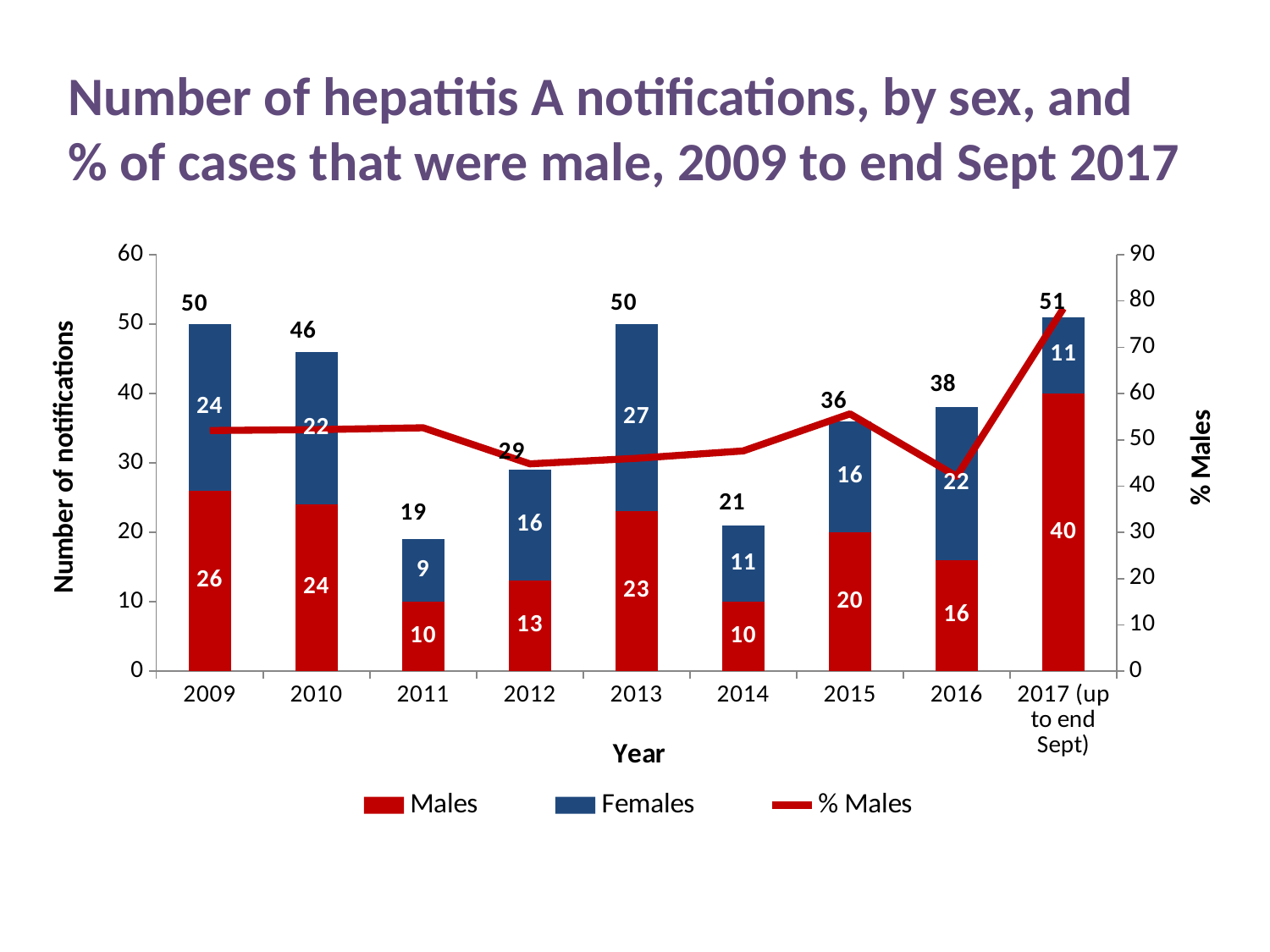
What is the total number of notifications shown for 2016? 38 What is the difference between the number of male notifications in 2009 and in 2011? 16 How many years are shown on the x axis? 9 In 2012, which is larger: the number of male notifications or the number of female notifications? Females What is the label of the right-hand vertical axis? % Males How many female hepatitis A notifications were there in 2013? 27 Which year has the highest total number of notifications? 2017 (up to end Sept) Which year has the lowest total number of notifications? 2011 Is the % Males value for 2016 greater or less than 50? less How many male hepatitis A notifications were there in 2017 (up to end Sept)? 40 Is the % Males value for 2017 (up to end Sept) greater or less than 70? greater How many series does the legend list? 3